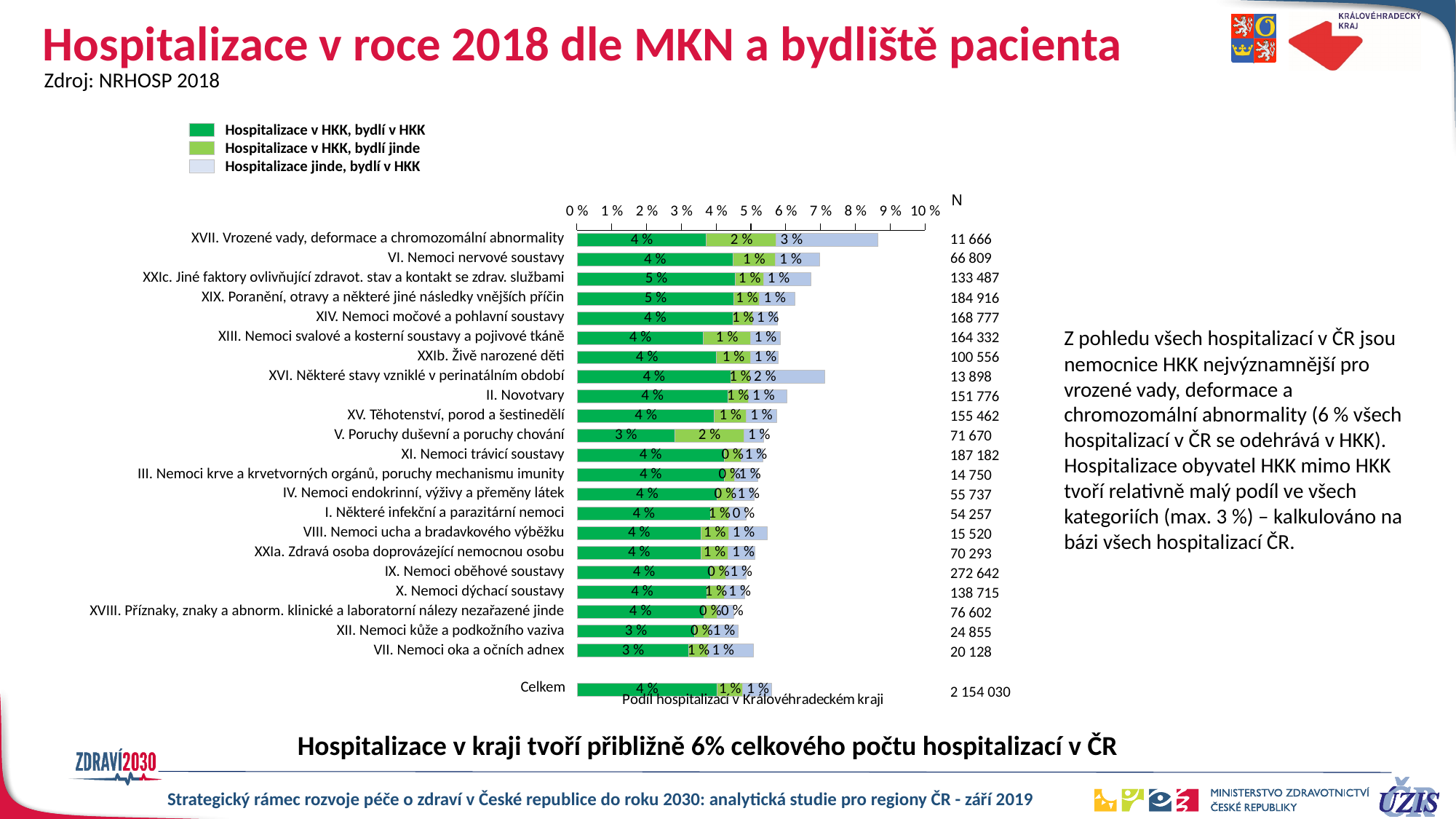
Which has the larger N value: 'XIX. Poranění, otravy a některé jiné následky vnějších příčin' or 'XI. Nemoci trávicí soustavy'? XI. Nemoci trávicí soustavy Is the total bar length for 'XVII. Vrozené vady, deformace a chromozomální abnormality' greater or less than 8 %? greater What is the value of 'Hospitalizace v HKK, bydlí jinde' for 'V. Poruchy duševní a poruchy chování'? 2 % Which category has the lowest N value? XVII. Vrozené vady, deformace a chromozomální abnormality How many bars (categories including Celkem) are plotted in the chart? 23 Which category has the highest N value? IX. Nemoci oběhové soustavy What kind of chart is shown on the slide? Stacked bar chart What is the N value shown for 'Celkem'? 2 154 030 How many series does the legend list? 3 What is the value of 'Hospitalizace v HKK, bydlí v HKK' for 'XVII. Vrozené vady, deformace a chromozomální abnormality'? 4 % What is the difference between the N values of 'IX. Nemoci oběhové soustavy' and 'X. Nemoci dýchací soustavy'? 133 927 What is the value of 'Hospitalizace jinde, bydlí v HKK' for 'XVII. Vrozené vady, deformace a chromozomální abnormality'? 3 %